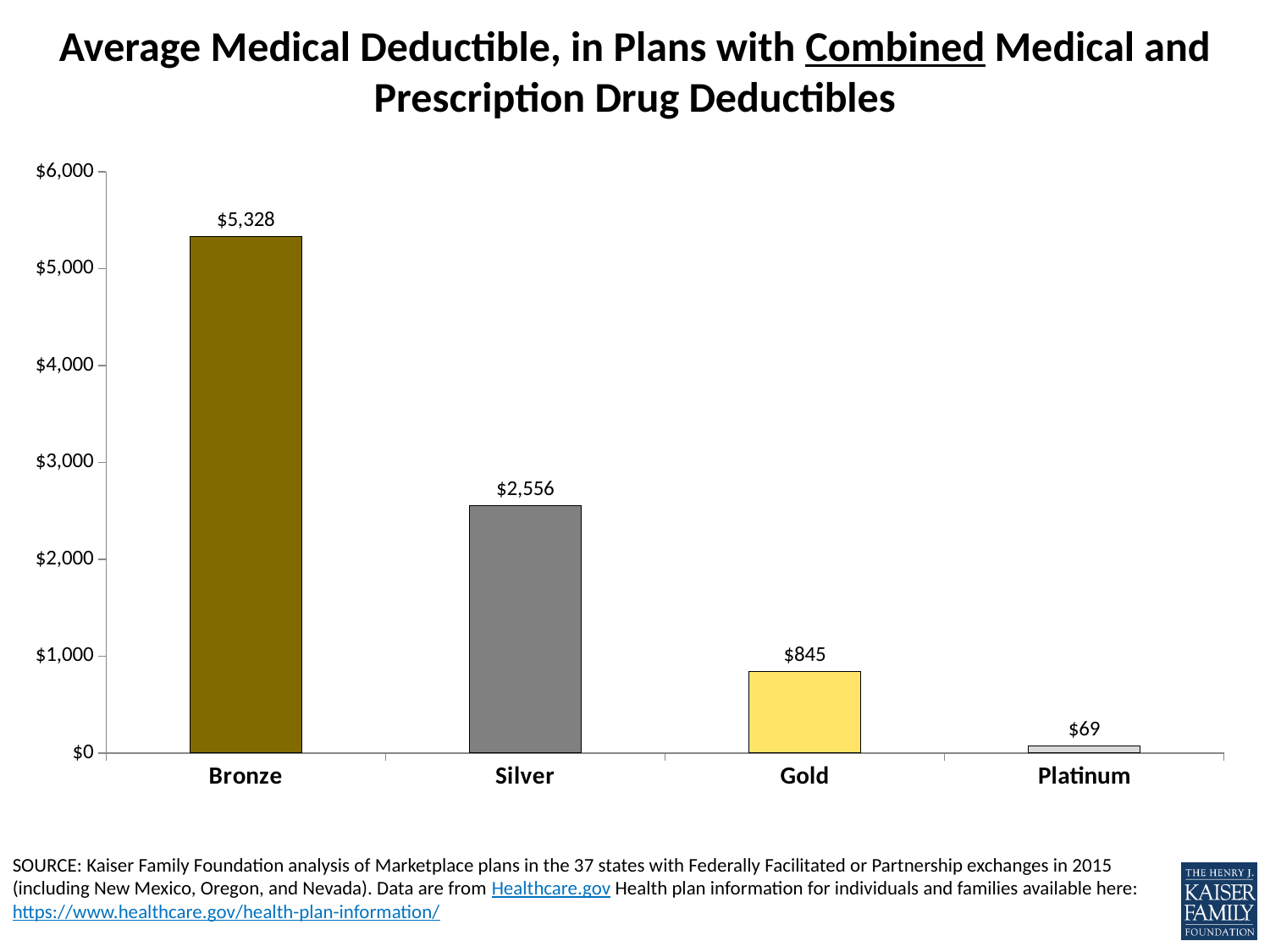
What is the average medical deductible for Bronze plans? $5,328 What is the average medical deductible for Platinum plans? $69 What kind of chart is shown on the slide? Bar chart Which plan type has the highest average medical deductible? Bronze What is the average medical deductible for Gold plans? $845 Which has a larger average medical deductible, Silver or Gold? Silver What is the difference between the Gold and Platinum average medical deductibles? $776 Is the value for Silver greater or less than $3,000? less What is the average medical deductible for Silver plans? $2,556 What is the difference between the Bronze and Silver average medical deductibles? $2,772 How many plan types are shown on the chart? 4 Which plan type has the lowest average medical deductible? Platinum